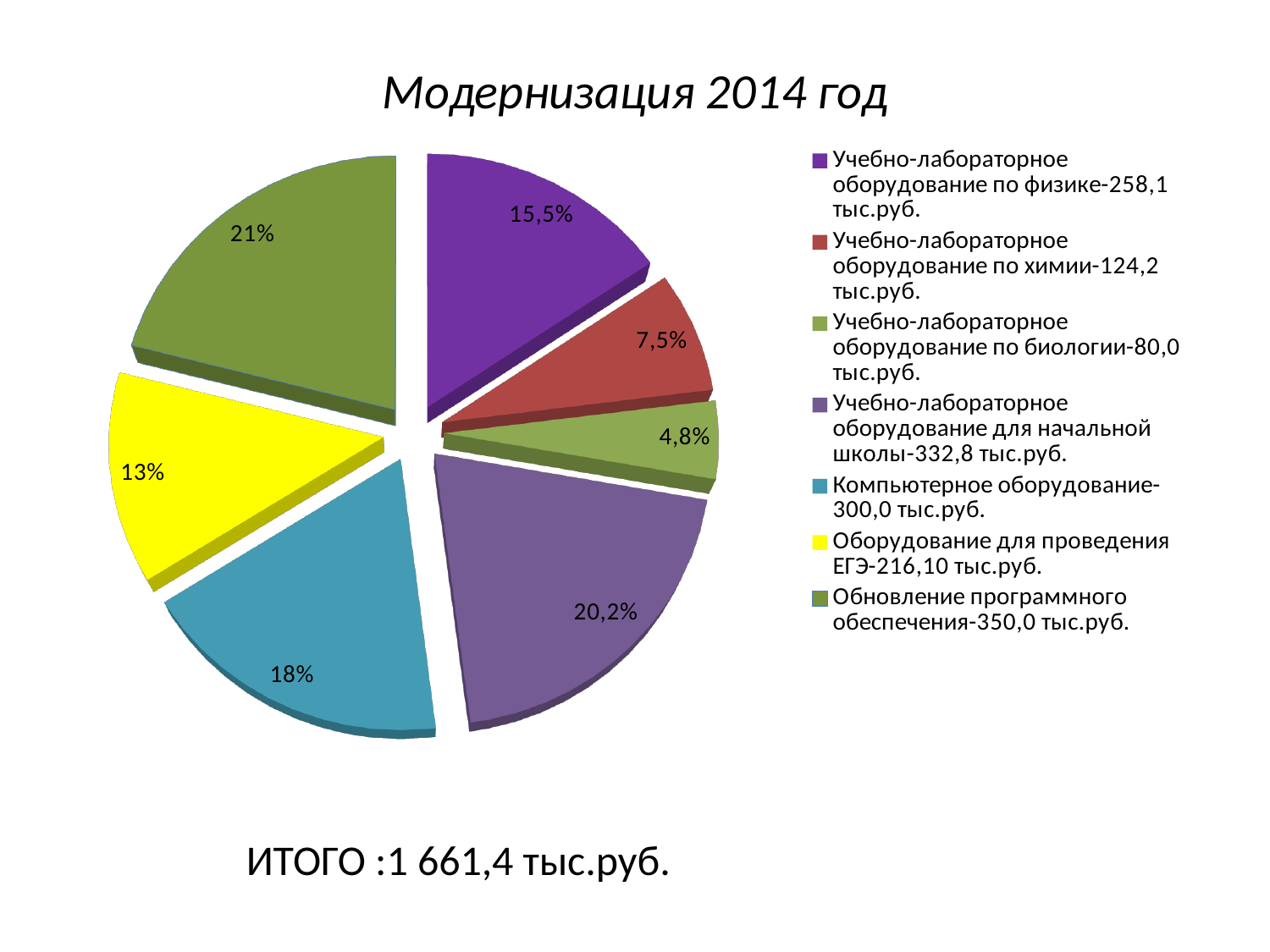
How many slices does the pie chart have? 7 What is the title of the chart? Модернизация 2014 год What kind of chart is shown on the slide? pie chart What share of the pie is labelled for Учебно-лабораторное оборудование по биологии? 4,8% What share of the pie is labelled for Компьютерное оборудование? 18% Which category has the largest share of the pie? Обновление программного обеспечения Which category has the smallest share of the pie? Учебно-лабораторное оборудование по биологии What is the difference in percentage points between the share for Обновление программного обеспечения and the share for Оборудование для проведения ЕГЭ? 8% What share of the pie is labelled for Учебно-лабораторное оборудование по химии? 7,5% Which has the larger share: Оборудование для проведения ЕГЭ or Компьютерное оборудование? Компьютерное оборудование